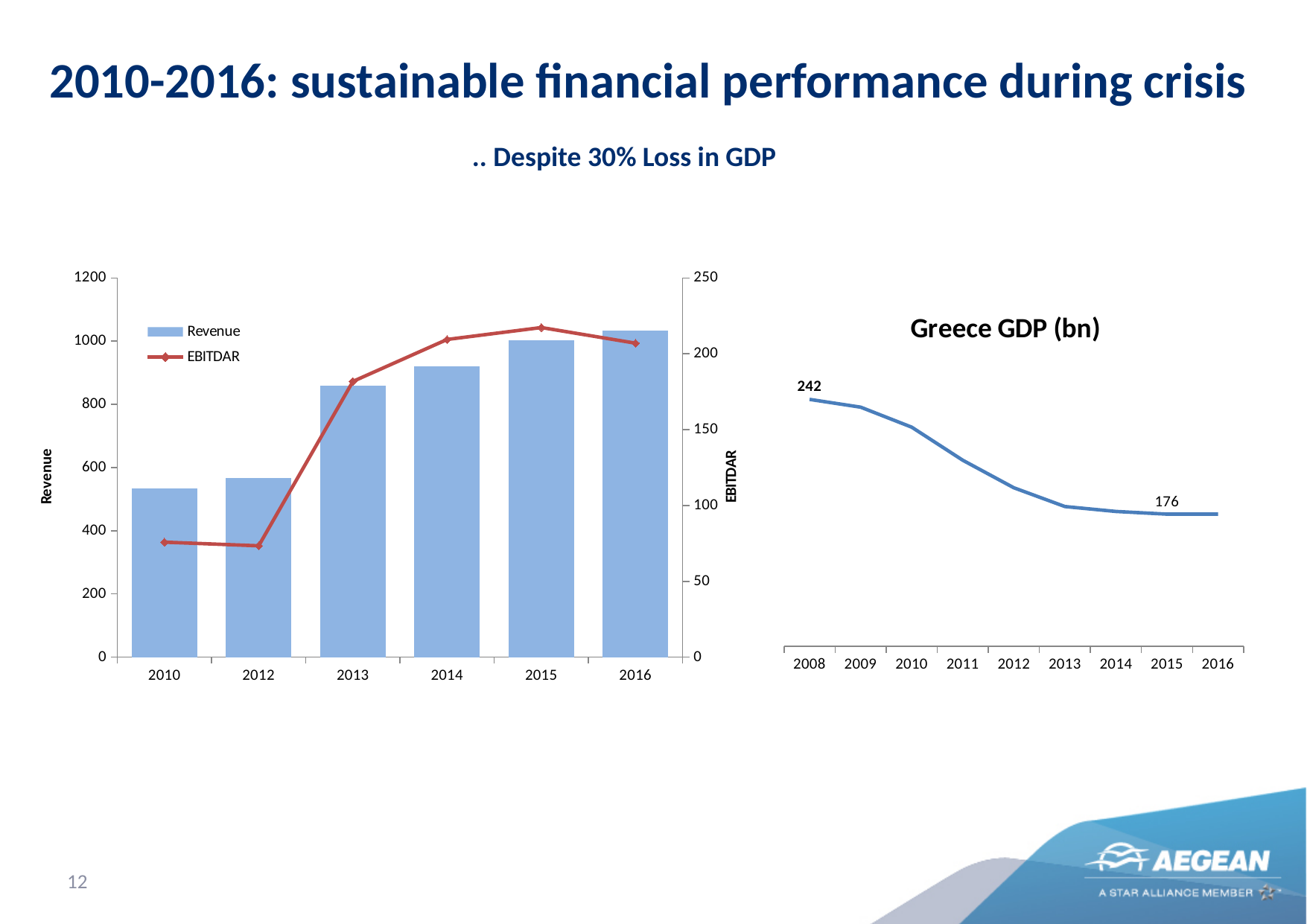
In the left chart, what is the label of the right-hand vertical axis? EBITDAR In the Greece GDP (bn) chart, what is the value for 2008? 242 In the Greece GDP (bn) chart, what is the difference between the 2008 and 2016 values? 66 In the left chart, how many years are shown on the x axis? 6 In the Greece GDP (bn) chart, do the values rise or fall from 2008 to 2016? fall In the left chart, which year has the highest Revenue bar? 2016 In the left chart, which year has the lowest Revenue bar? 2010 In the left chart, how many series does the legend list? 2 In the left chart, which year has the highest EBITDAR value? 2015 In the left chart, is the Revenue value for 2013 greater or less than 800? greater In the Greece GDP (bn) chart, what is the value for 2016? 176 In the left chart, is the EBITDAR value for 2012 greater or less than 100? less